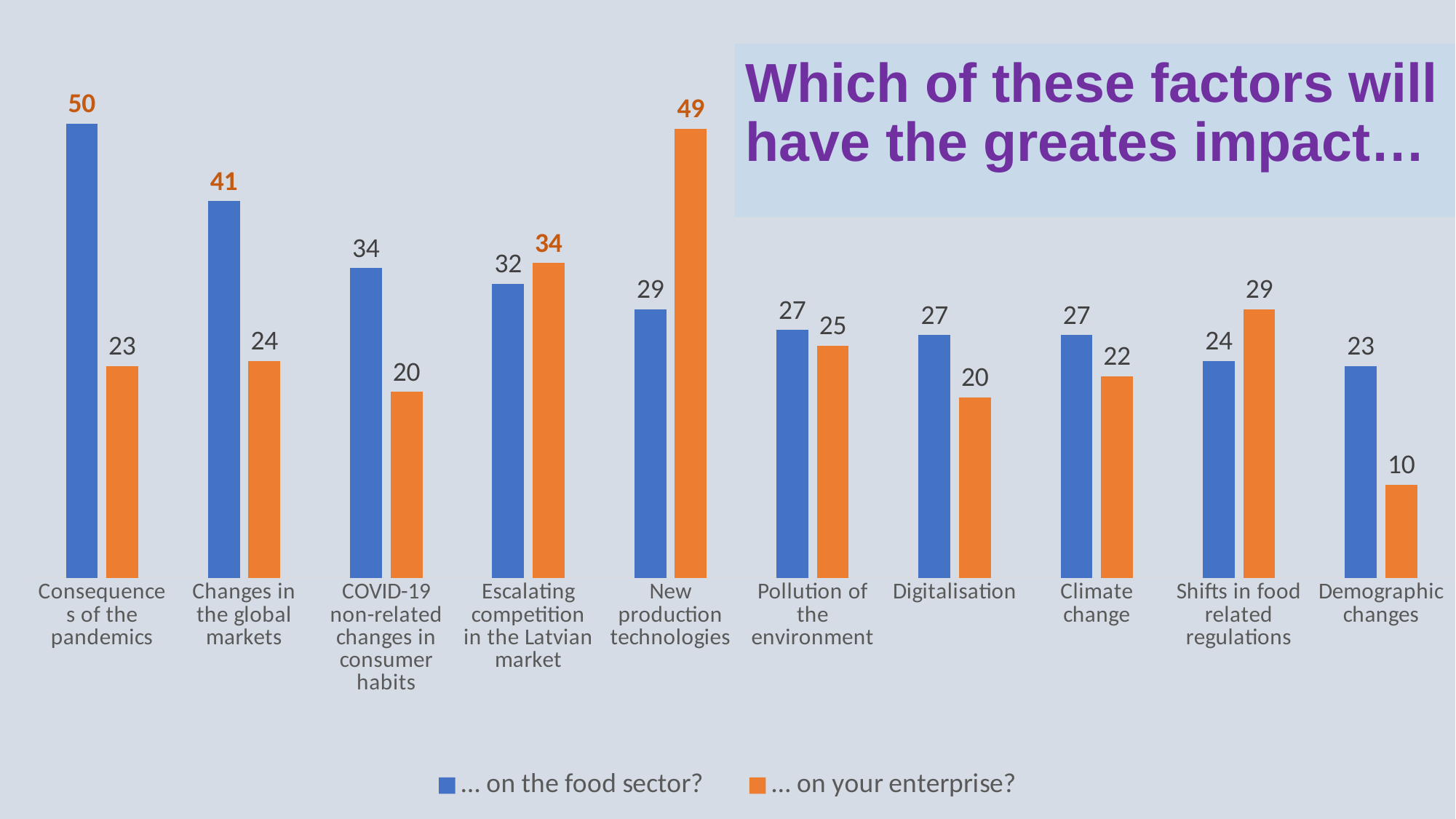
Which category has the highest value in the '… on the food sector?' series? Consequences of the pandemics How many categories are shown on the x axis? 10 What is the value for 'New production technologies' in the '… on your enterprise?' series? 49 What is the difference between the '… on the food sector?' and '… on your enterprise?' values for 'Changes in the global markets'? 17 How many series does the legend list? 2 What is the value for 'Demographic changes' in the '… on your enterprise?' series? 10 For 'Shifts in food related regulations', which series has the larger value: '… on the food sector?' or '… on your enterprise?'? … on your enterprise? What is the value for 'Consequences of the pandemics' in the '… on the food sector?' series? 50 What kind of chart is shown on the slide? Bar chart What is the title of the chart? Which of these factors will have the greates impact… What is the value for 'Digitalisation' in the '… on your enterprise?' series? 20 Which category has the lowest value in the '… on your enterprise?' series? Demographic changes